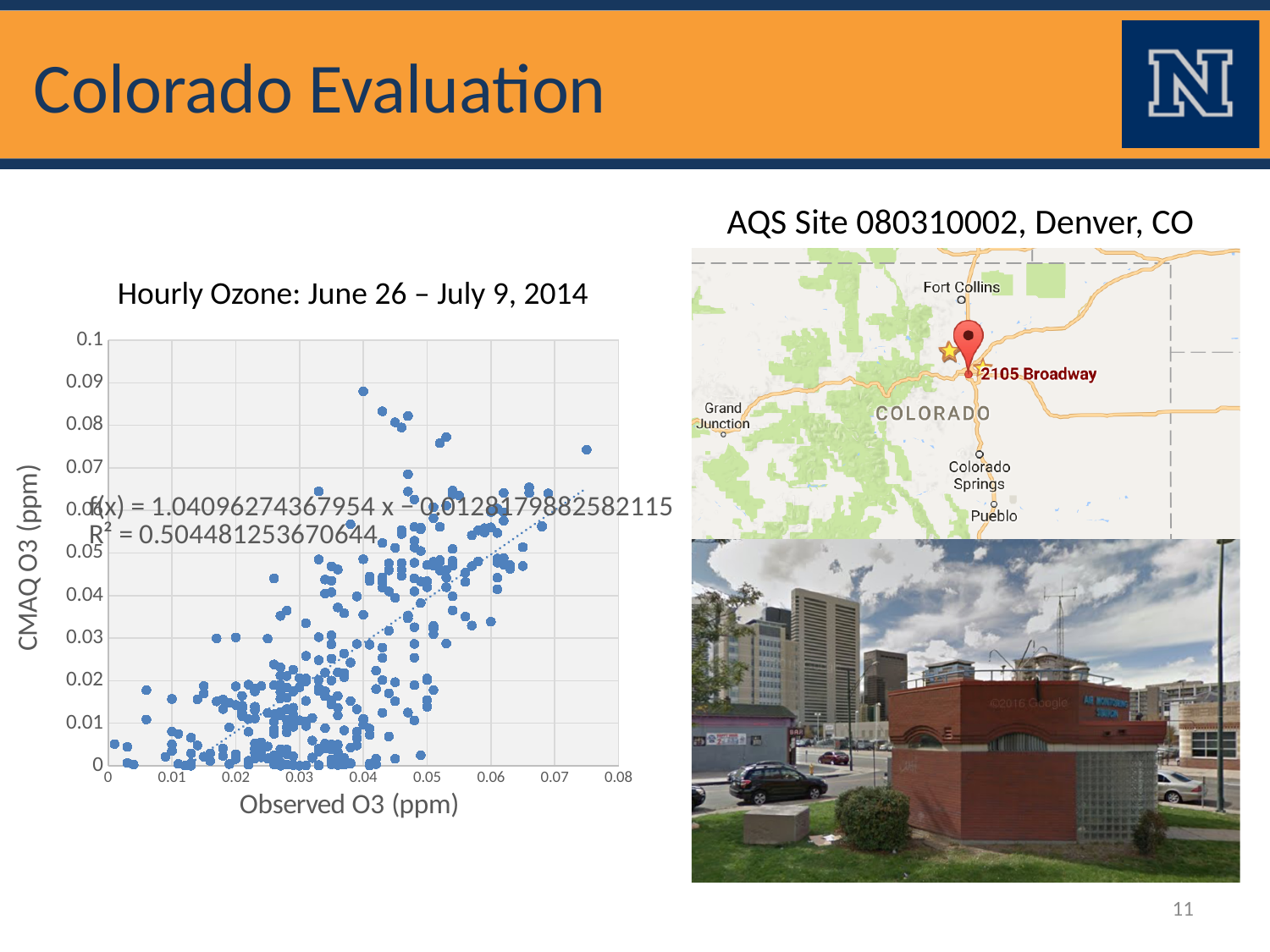
Do the CMAQ O3 values generally rise or fall as Observed O3 increases along the x axis? Rise What is the intercept of the trendline equation shown on the chart? −0.0128179882582115 What is the maximum value shown on the x axis (Observed O3) of the chart? 0.08 Is the highest CMAQ O3 value plotted on the chart greater or less than 0.08? greater What is the R² value shown on the chart? 0.504481253670644 What is the title of the chart on the slide? Hourly Ozone: June 26 – July 9, 2014 Is the CMAQ O3 value of the point with the largest Observed O3 greater or less than 0.07? greater Is the R² value of the trendline greater or less than 0.5? greater What kind of chart is shown on the slide? Scatter chart What is the label of the x axis of the chart? Observed O3 (ppm) What is the slope of the trendline equation shown on the chart? 1.04096274367954 What is the maximum value shown on the y axis (CMAQ O3) of the chart? 0.1